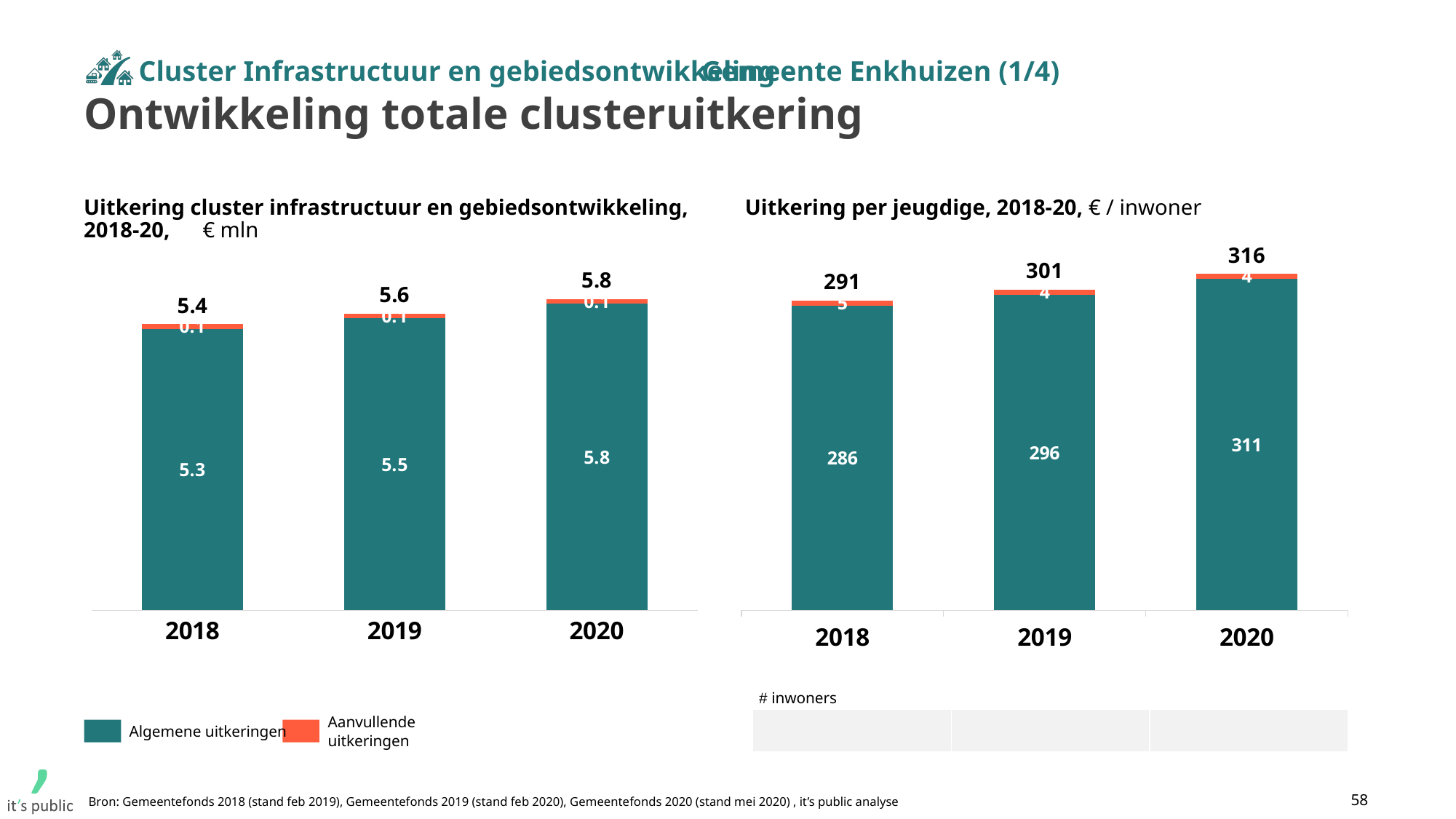
In the right chart (Uitkering per jeugdige), what is the value of Aanvullende uitkeringen in 2018? 5 In the left chart (Uitkering cluster infrastructuur en gebiedsontwikkeling), what is the value of Algemene uitkeringen in 2019? 5.5 In the right chart (Uitkering per jeugdige), what is the total value of the 2019 bar? 301 In the left chart (Uitkering cluster infrastructuur en gebiedsontwikkeling), what is the total value of the 2018 bar? 5.4 What kind of chart is the left chart (Uitkering cluster infrastructuur en gebiedsontwikkeling)? stacked bar chart How many series does the legend list? 2 In the left chart (Uitkering cluster infrastructuur en gebiedsontwikkeling), which year has the highest total? 2020 In the right chart (Uitkering per jeugdige), what is the value of Algemene uitkeringen in 2020? 311 In the right chart (Uitkering per jeugdige), which year has the lowest total? 2018 In the left chart (Uitkering cluster infrastructuur en gebiedsontwikkeling), do the totals rise or fall from 2018 to 2020? rise In the right chart (Uitkering per jeugdige), what is the difference between the 2020 total and the 2019 total? 15 In the left chart (Uitkering cluster infrastructuur en gebiedsontwikkeling), what is the difference between the 2020 total and the 2018 total? 0.4